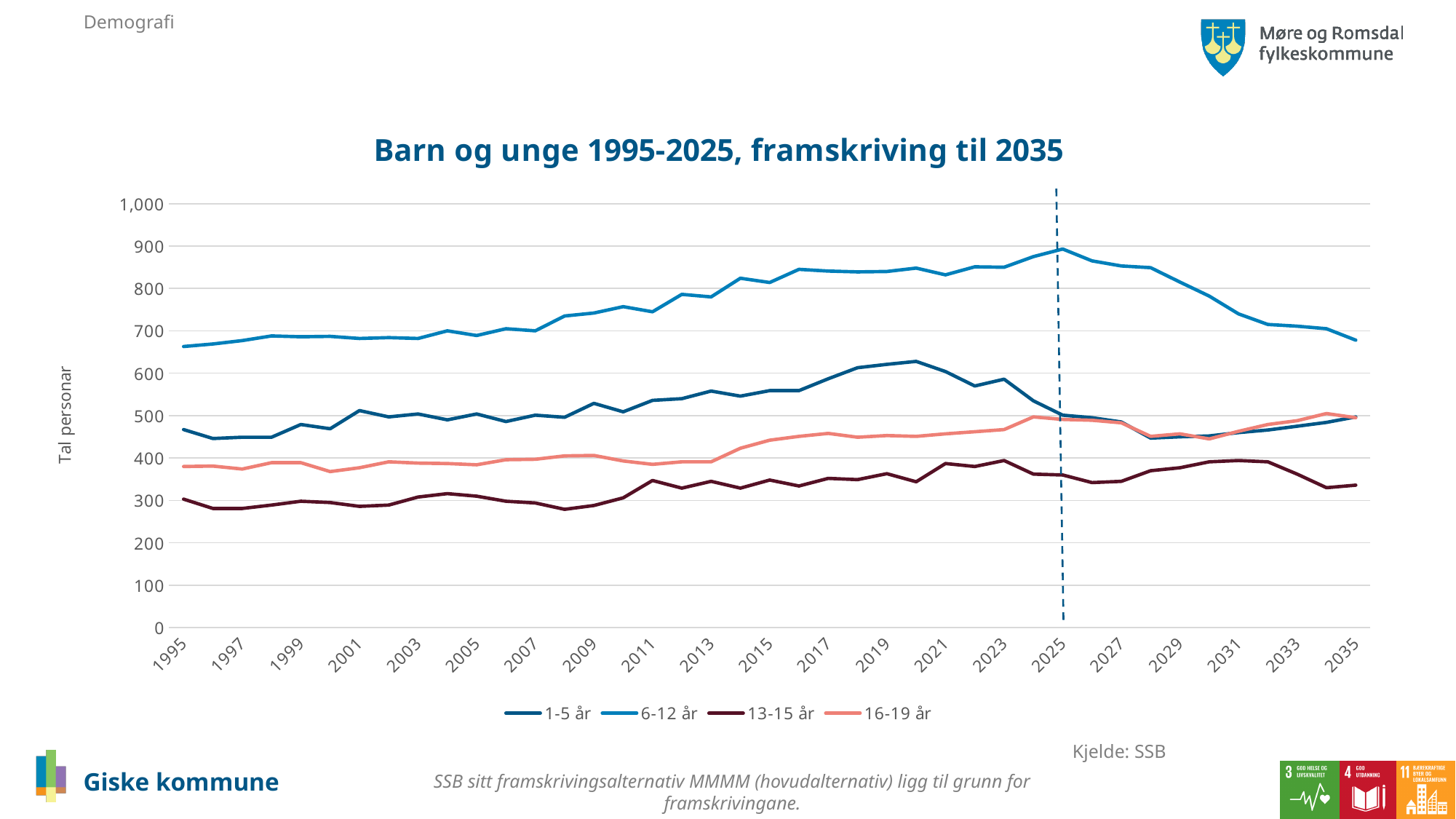
Is the value for 16-19 år in 2035 greater or less than 400? greater What kind of chart is shown on the slide? line chart Which age group has the highest value in 2025? 6-12 år Does the 1-5 år series rise or fall from 2020 to 2028? fall Is the value for 6-12 år in 2025 greater or less than 800? greater Is the value for 13-15 år in 1997 greater or less than 300? less Which age group has the lowest value in 1995? 13-15 år How many series does the legend list? 4 What is the title of the chart? Barn og unge 1995-2025, framskriving til 2035 In 2019, which is larger: the value for 1-5 år or for 16-19 år? 1-5 år Does the 6-12 år series rise or fall from 2025 to 2035? fall Which age groups are listed in the legend? 1-5 år, 6-12 år, 13-15 år, 16-19 år